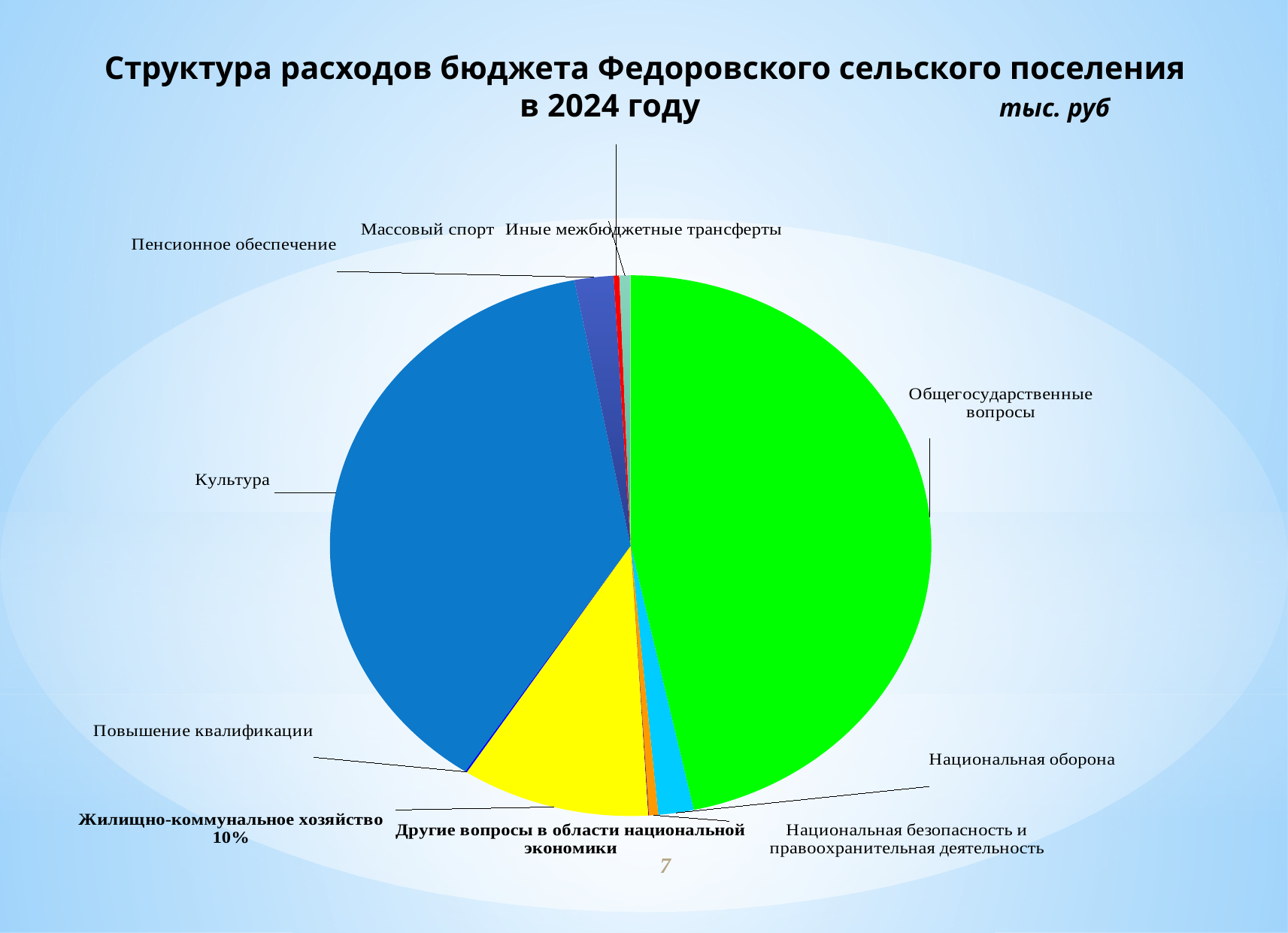
How many categories (slices) are labelled on the pie chart? 10 What kind of chart is shown on the slide? pie chart Which category has the largest slice of the pie? Общегосударственные вопросы Which slice is larger: Общегосударственные вопросы or Культура? Общегосударственные вопросы What share of the pie does Жилищно-коммунальное хозяйство account for? 10% What colour is the slice for Общегосударственные вопросы? green Which slice is larger: Пенсионное обеспечение or Массовый спорт? Пенсионное обеспечение What is the title of the chart? Структура расходов бюджета Федоровского сельского поселения в 2024 году Which slice is larger: Другие вопросы в области национальной экономики or Национальная оборона? Национальная оборона